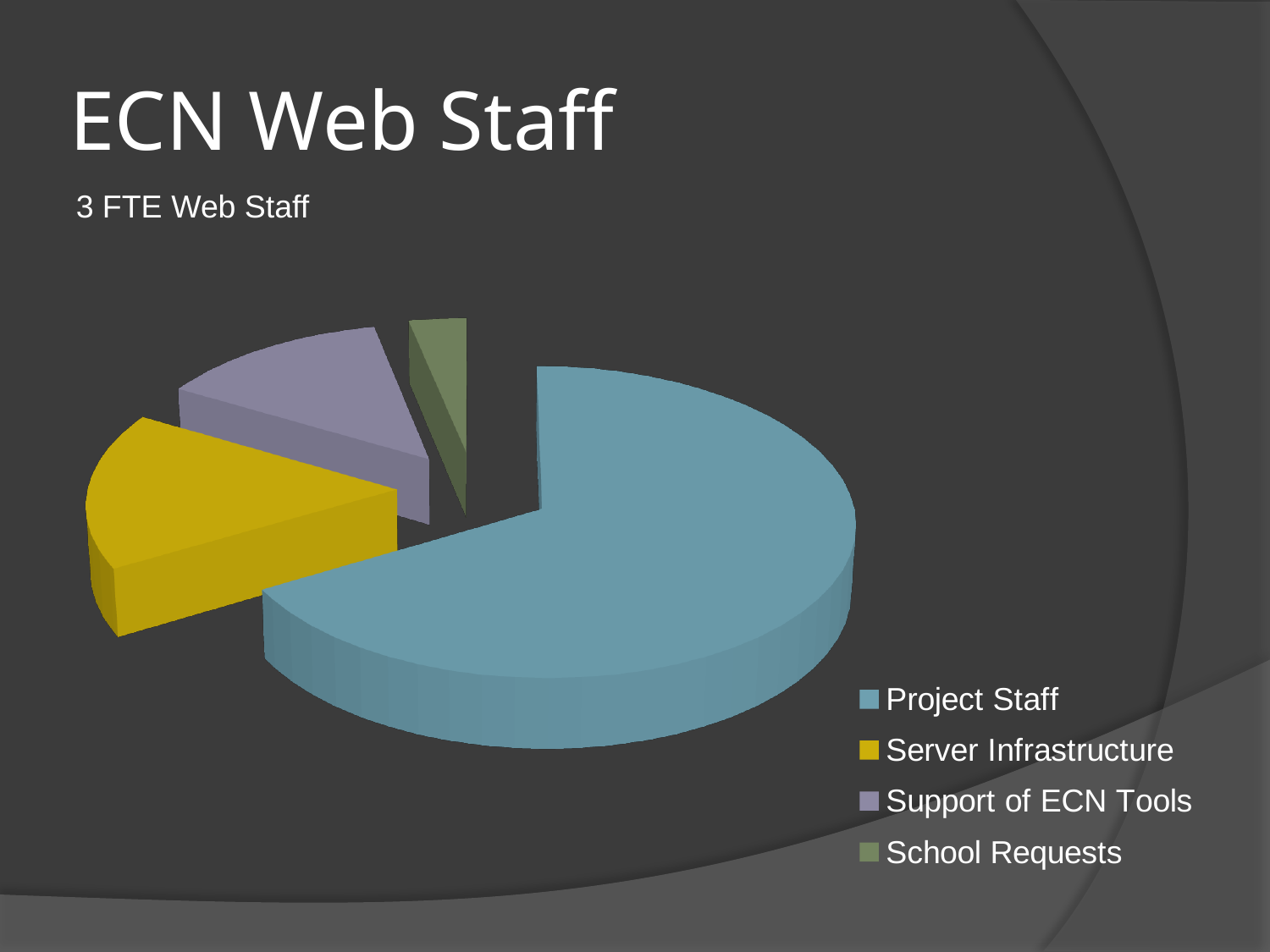
Which slice is larger, Server Infrastructure or School Requests? Server Infrastructure How many slices does the pie chart have? 4 What kind of chart is shown on the slide? pie chart Which category is shown in yellow in the pie chart? Server Infrastructure Which category is shown in purple in the pie chart? Support of ECN Tools Which category has the smallest slice of the pie? School Requests Which slice is larger, Server Infrastructure or Support of ECN Tools? Server Infrastructure How many entries does the legend list? 4 Which category has the largest slice of the pie? Project Staff Which slice is larger, Project Staff or Support of ECN Tools? Project Staff